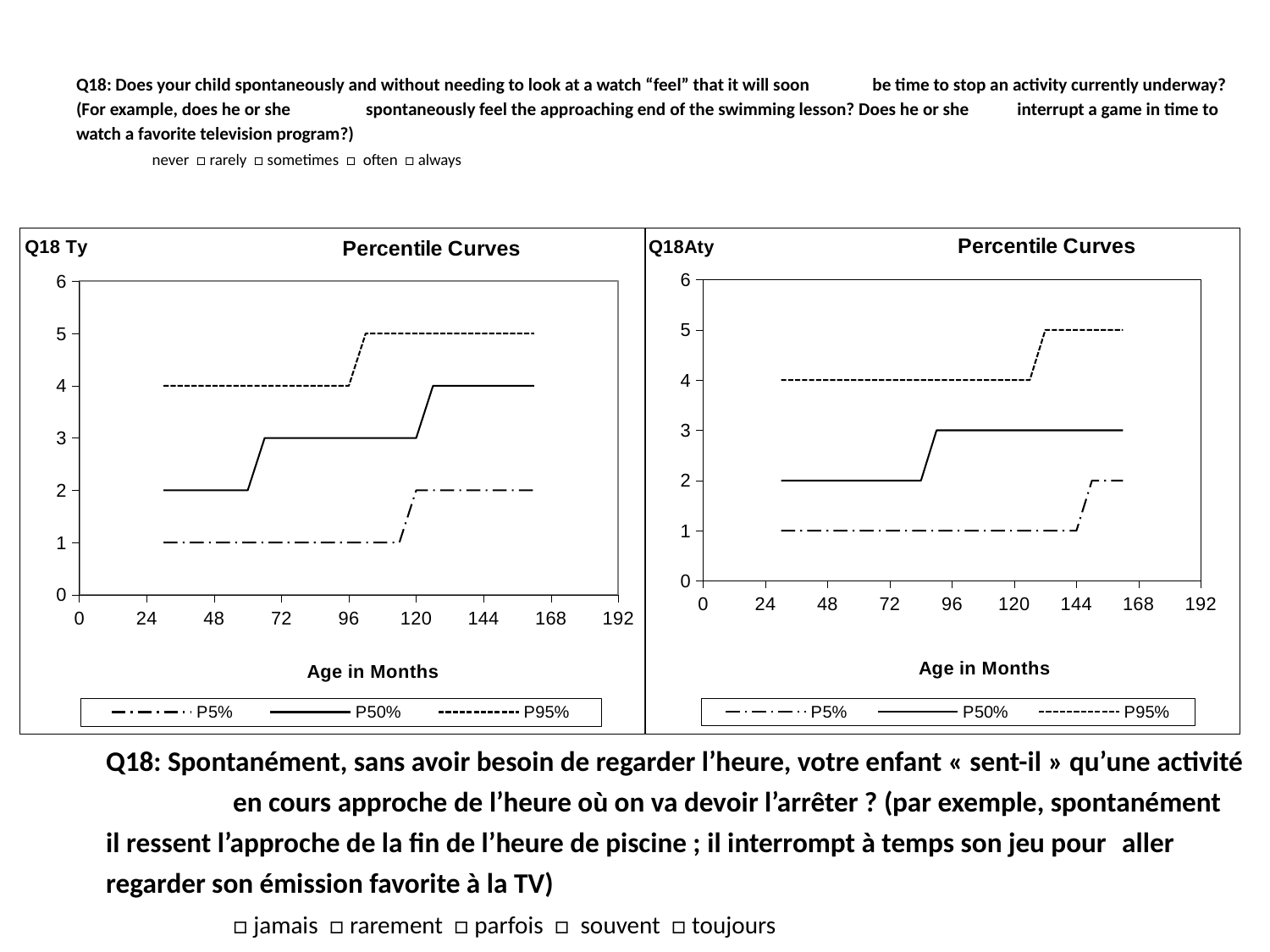
What is the title of the left chart labelled Q18 Ty? Percentile Curves How many series does the legend of the right chart (Q18Aty) list? 3 In the left chart (Q18 Ty), what is the value of the P95% curve at 48 months? 4 In the right chart (Q18Aty), what is the value of the P5% curve at 96 months? 1 What is the x-axis label of the right chart (Q18Aty)? Age in Months In the left chart (Q18 Ty), what is the value of the P50% curve at 144 months? 4 In the left chart (Q18 Ty), what is the value of the P50% curve at 48 months? 2 In the left chart (Q18 Ty), which curve is higher at 120 months, P50% or P5%? P50% What kind of chart is the left chart labelled Q18 Ty? line chart In the right chart (Q18Aty), does the P50% curve rise or fall as age increases? rise In the right chart (Q18Aty), what is the value of the P50% curve at 144 months? 3